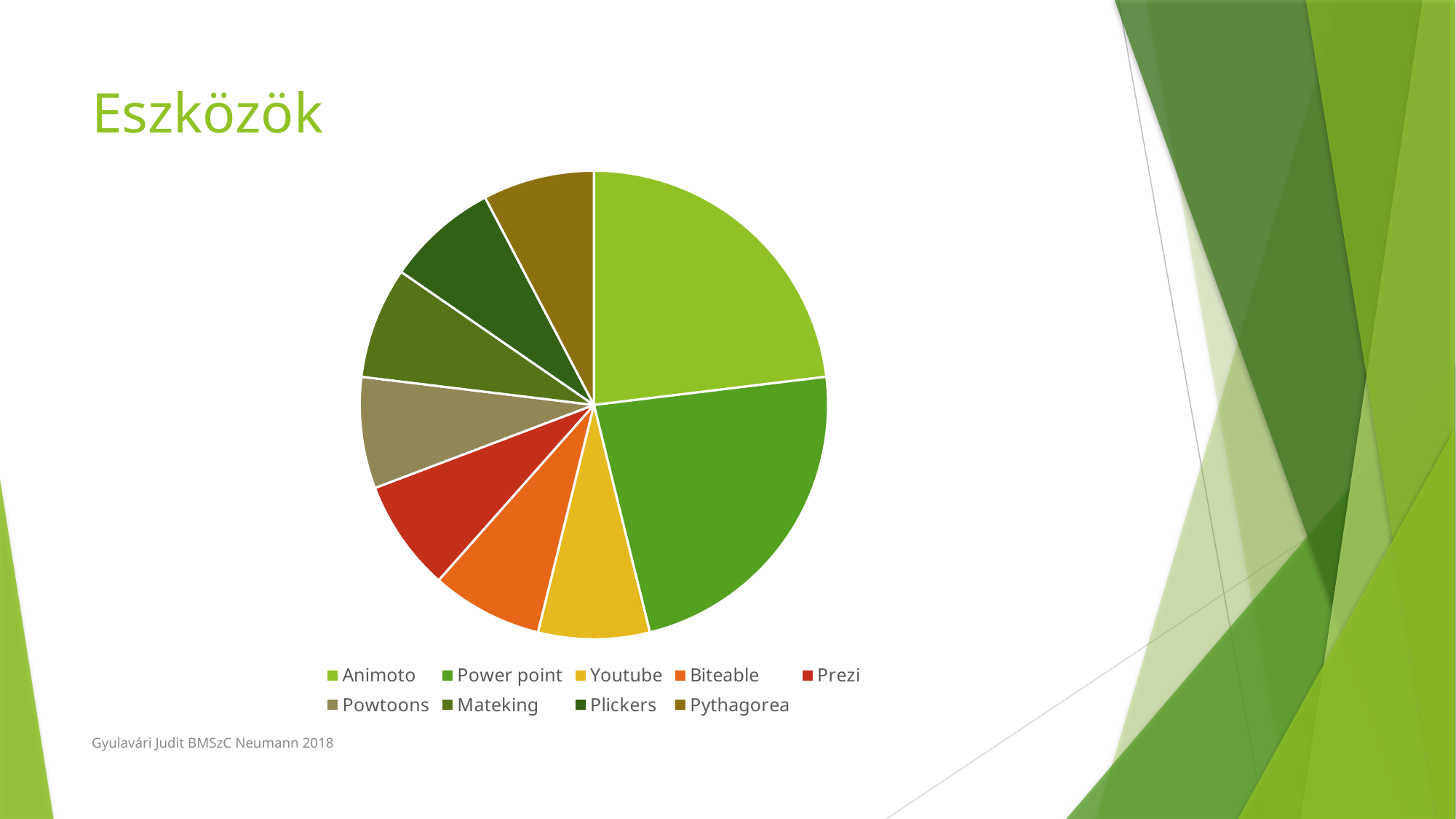
Which legend entry of the pie chart is shown in yellow? Youtube What kind of chart is shown on the slide? pie chart Which slice is larger in the pie chart, Power point or Prezi? Power point What is the title of the slide containing the pie chart? Eszközök Which slice is larger in the pie chart, Pythagorea or Animoto? Animoto Which slice is larger in the pie chart, Animoto or Youtube? Animoto How many entries does the legend of the pie chart list? 9 How many categories does the pie chart show? 9